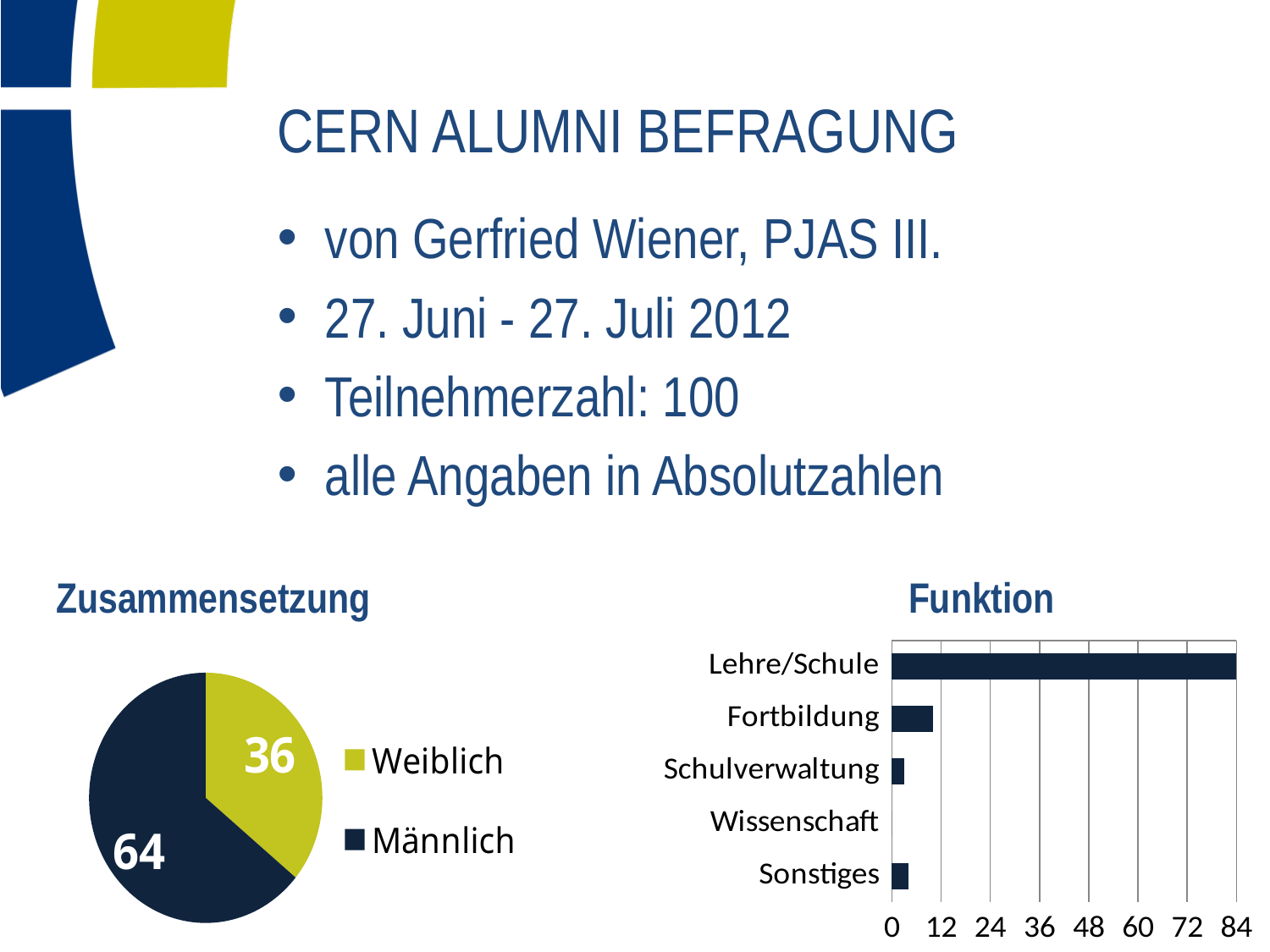
In the Zusammensetzung pie chart, how many slices are there? 2 In the Funktion chart, which category has the highest value? Lehre/Schule What kind of chart is the Funktion chart? bar chart In the Zusammensetzung pie chart, what share of the pie does Weiblich represent? 36% In the Zusammensetzung pie chart, what is the difference between the Männlich and Weiblich values? 28 In the Funktion chart, is the value for Fortbildung greater or less than 24? less In the Zusammensetzung pie chart, what is the value for Weiblich? 36 In the Zusammensetzung pie chart, which slice is larger, Weiblich or Männlich? Männlich What kind of chart is the Zusammensetzung chart? pie chart In the Funktion chart, how many categories are shown? 5 In the Zusammensetzung pie chart, what is the value for Männlich? 64 In the Funktion chart, is the value for Lehre/Schule greater or less than 72? greater